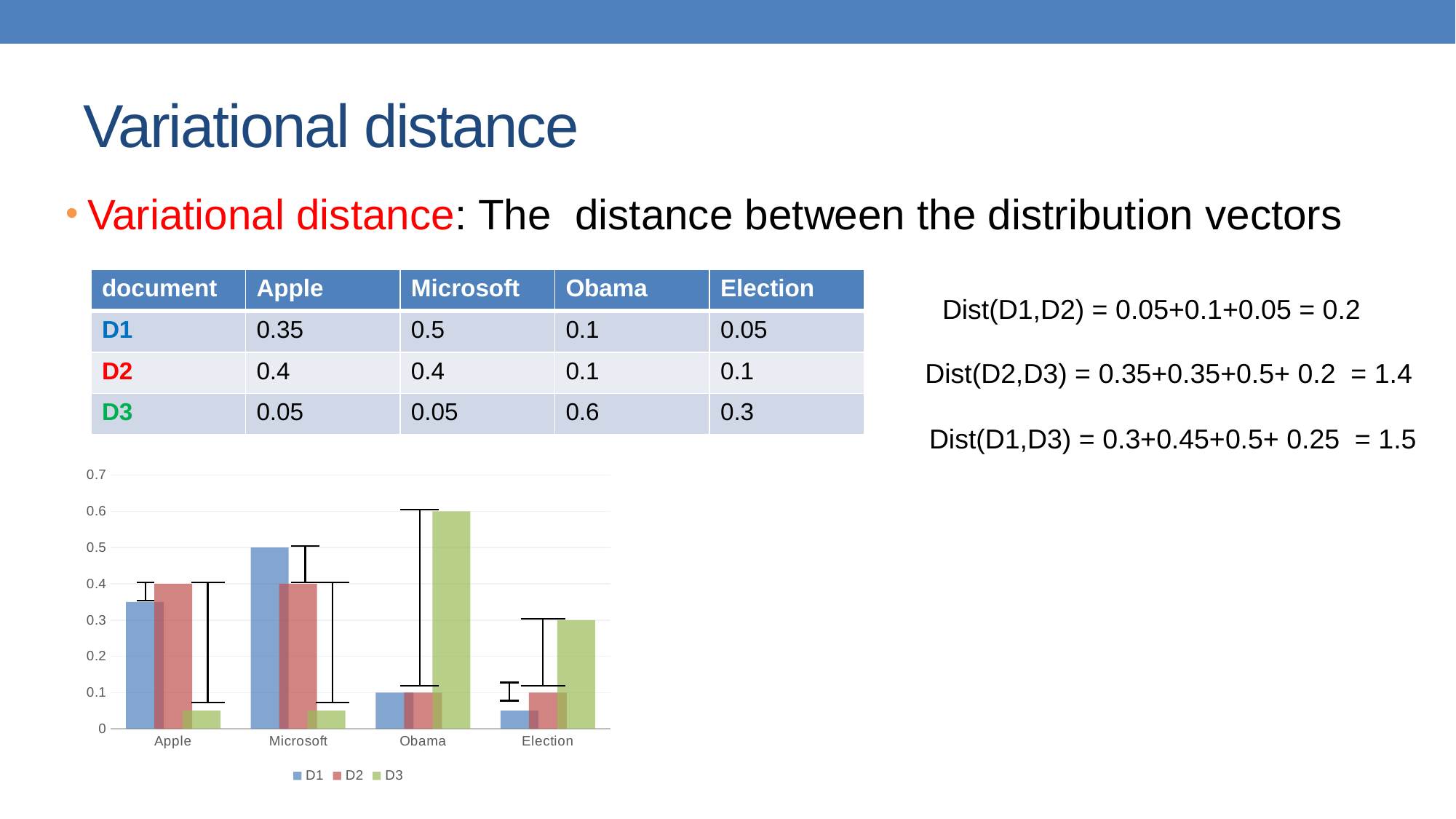
How many categories are shown on the x axis of the chart? 4 In the chart, is the D1 value for Apple greater or less than 0.3? greater What is the value of D1 for Microsoft in the chart? 0.5 Which category has the highest D3 value in the chart? Obama What is the value of D3 for Obama in the chart? 0.6 Which category has the lowest D1 value in the chart? Election How many series does the chart legend list? 3 In the chart, is the D3 value for Microsoft greater or less than 0.1? less In the chart, which is larger for Obama: D1 or D3? D3 What kind of chart is shown on the slide? bar chart What is the value of D3 for Election in the chart? 0.3 What is the difference between the D1 and D3 values for Microsoft in the chart? 0.45